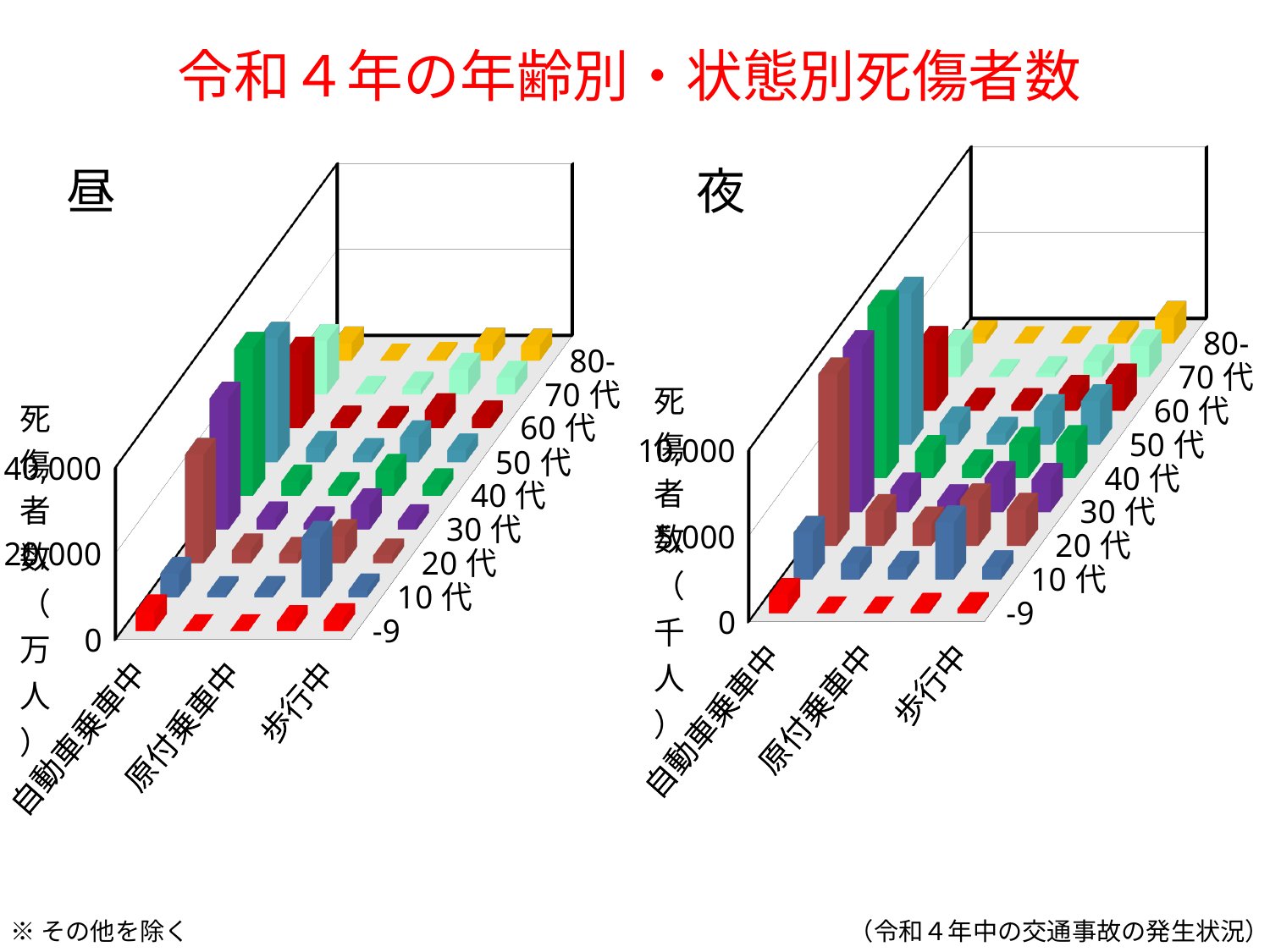
How many age groups are shown along the depth axis of the 夜 chart? 9 In the 昼 chart, which category has the tallest bars overall? 自動車乗車中 In the 夜 chart, which is larger for 30代: 自動車乗車中 or 原付乗車中? 自動車乗車中 In the 昼 chart, is the value for 歩行中 in the -9 age group greater or less than 20,000? less In the 昼 chart, which is larger for 20代: 自動車乗車中 or 歩行中? 自動車乗車中 What is the title of the slide? 令和４年の年齢別・状態別死傷者数 What kind of chart is the 昼 chart on the left? bar chart In the 夜 chart, is the value for 歩行中 in the -9 age group greater or less than 5,000? less In the 夜 chart, which category has the tallest bars overall? 自動車乗車中 What unit is used on the vertical axis of the 夜 chart? 千人